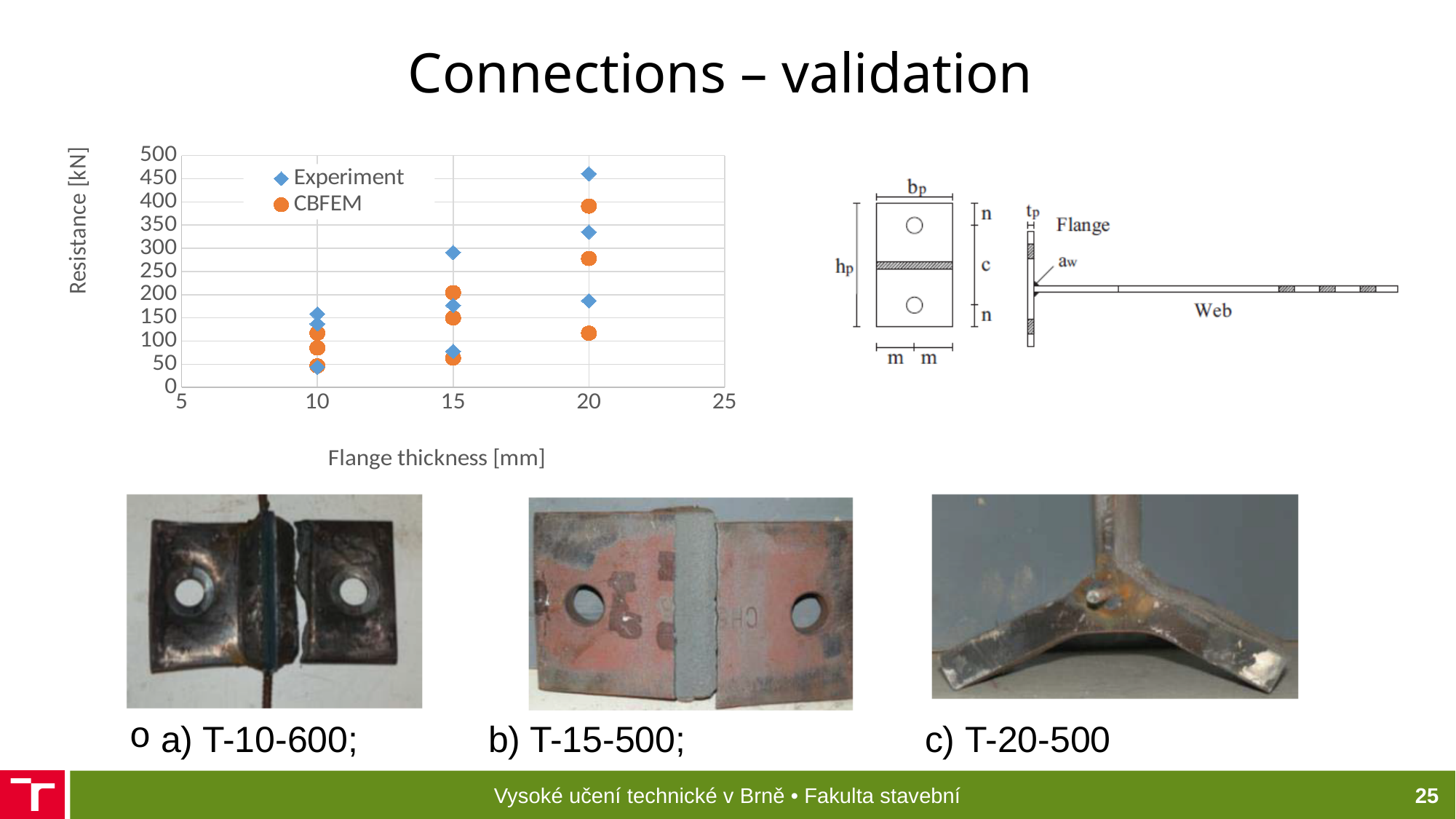
At how many distinct flange thickness values are data points plotted in the chart? 3 What kind of chart is shown on the slide? scatter chart Is the highest Experiment value at a flange thickness of 20 mm greater or less than 400 kN? greater Is the highest CBFEM value at a flange thickness of 20 mm greater or less than 350 kN? greater Which series has the single highest plotted point in the chart, Experiment or CBFEM? Experiment What are the two series named in the chart legend? Experiment and CBFEM What is the label of the vertical axis of the chart? Resistance [kN] Is the lowest Experiment value at a flange thickness of 10 mm greater or less than 100 kN? less At which flange thickness is the highest resistance value plotted? 20 How many series does the chart legend list? 2 Does the maximum resistance plotted rise or fall as flange thickness increases from 10 mm to 20 mm? rise